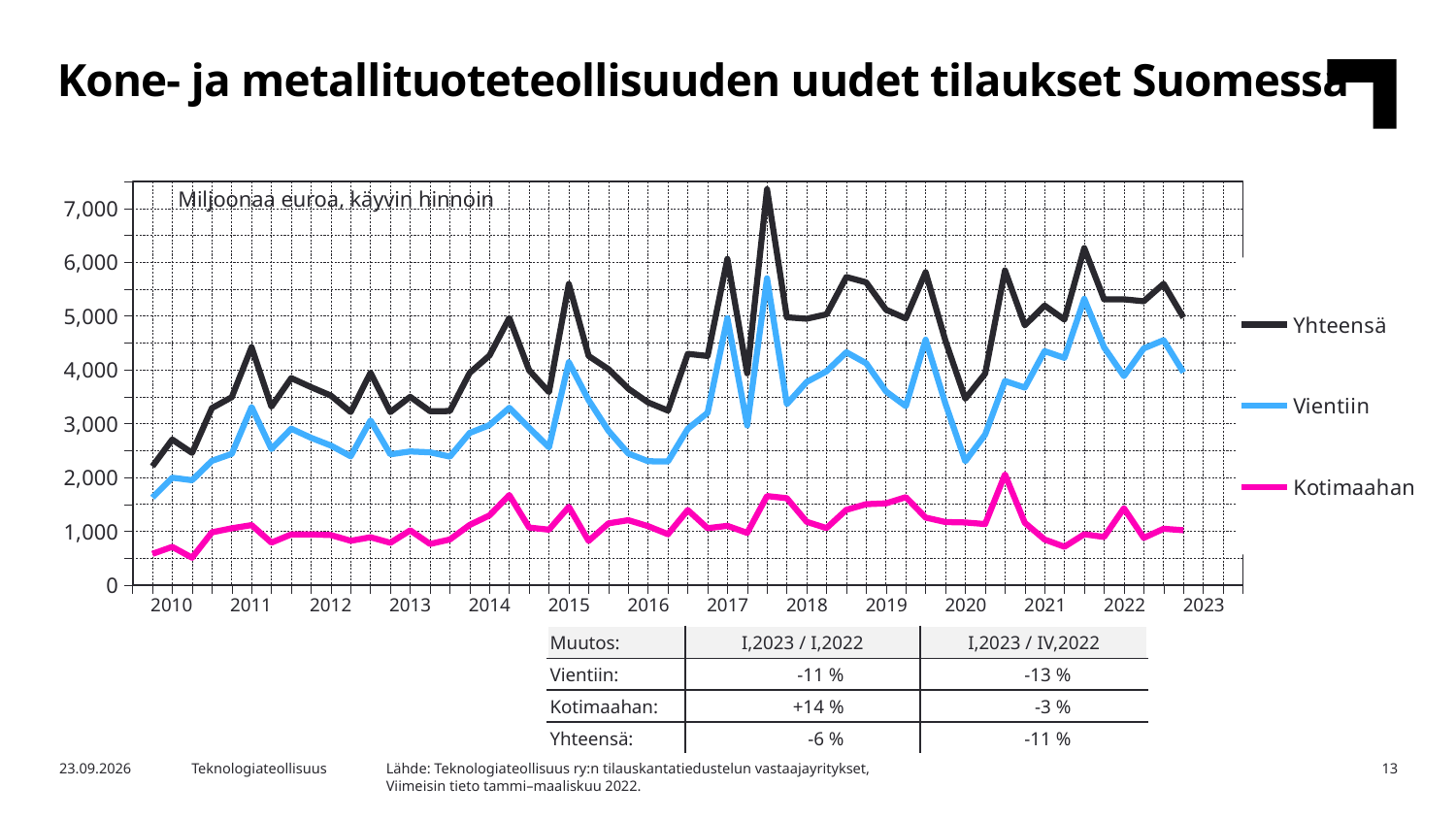
Which series has the lowest values throughout the chart? Kotimaahan Is the value of Kotimaahan at the start of 2010 greater or less than 1,000? less Which series is plotted with the black line? Yhteensä How many series does the chart legend list? 3 Does the Yhteensä line overall rise or fall from 2010 to 2023? rise What unit is stated in the chart's subtitle? Miljoonaa euroa, käyvin hinnoin Which series is larger in 2021, Vientiin or Kotimaahan? Vientiin What kind of chart is shown on the slide? Line chart Is the highest peak of the Vientiin line greater or less than 5,000? greater Is the highest peak of the Yhteensä line greater or less than 7,000? greater In which year does the Yhteensä line reach its highest peak? 2017